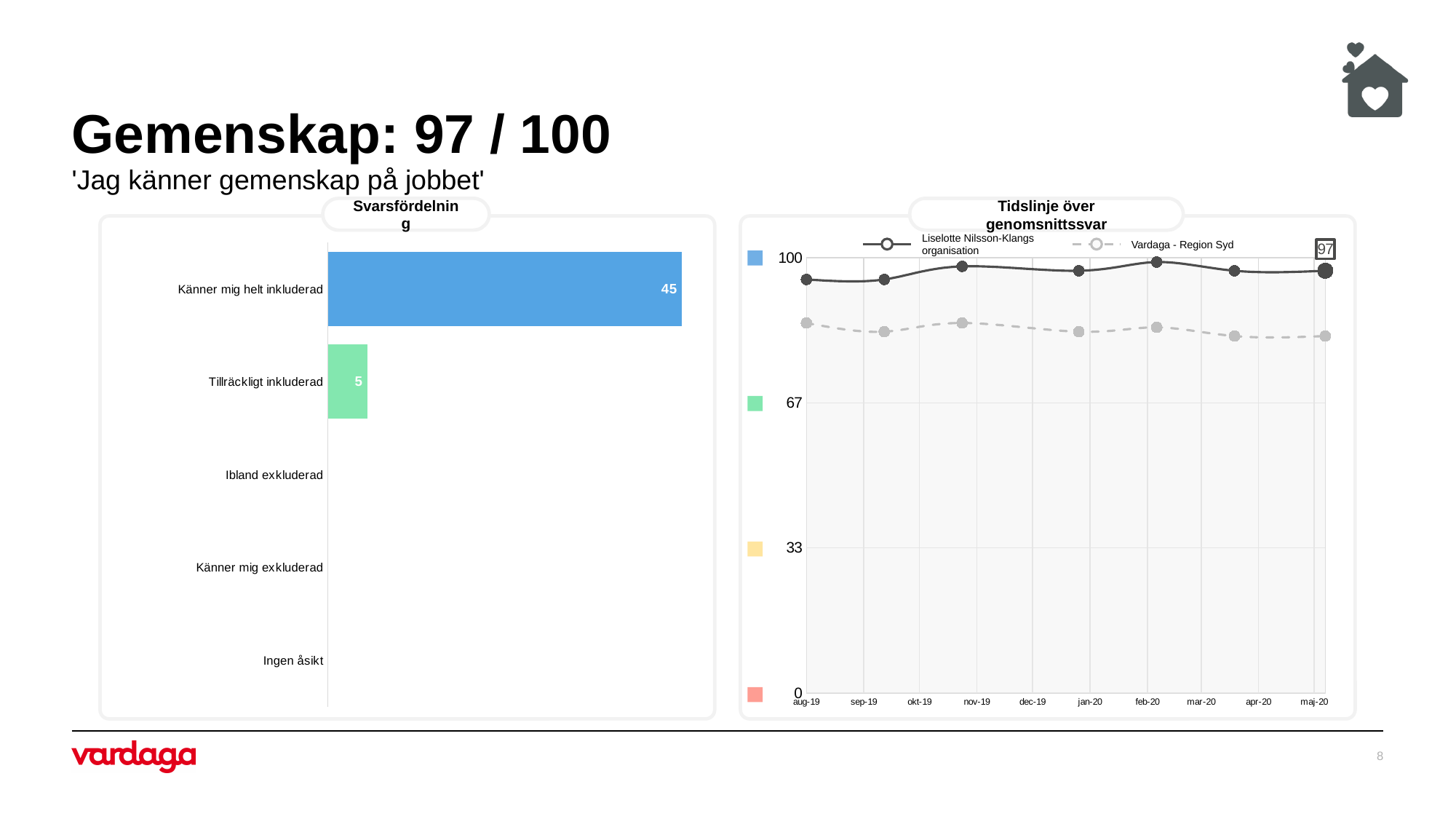
What kind of chart is the 'Tidslinje över genomsnittssvar' chart? Line chart How many series does the legend of the 'Tidslinje över genomsnittssvar' chart list? 2 In the 'Tidslinje över genomsnittssvar' chart, what is the labelled value for 'Liselotte Nilsson-Klangs organisation' at maj-20? 97 In the 'Svarsfördelning' chart, what is the value for 'Tillräckligt inkluderad'? 5 In the 'Svarsfördelning' chart, which is larger: 'Känner mig helt inkluderad' or 'Tillräckligt inkluderad'? Känner mig helt inkluderad How many time points are shown on the x axis of the 'Tidslinje över genomsnittssvar' chart? 10 In the 'Svarsfördelning' chart, which category has the highest value? Känner mig helt inkluderad In the 'Svarsfördelning' chart, what is the difference between 'Känner mig helt inkluderad' and 'Tillräckligt inkluderad'? 40 In the 'Svarsfördelning' chart, what is the value for 'Känner mig helt inkluderad'? 45 What kind of chart is the 'Svarsfördelning' chart? Bar chart How many categories are listed on the 'Svarsfördelning' chart? 5 In the 'Tidslinje över genomsnittssvar' chart, is the value for 'Vardaga - Region Syd' at maj-20 greater or less than 67? greater